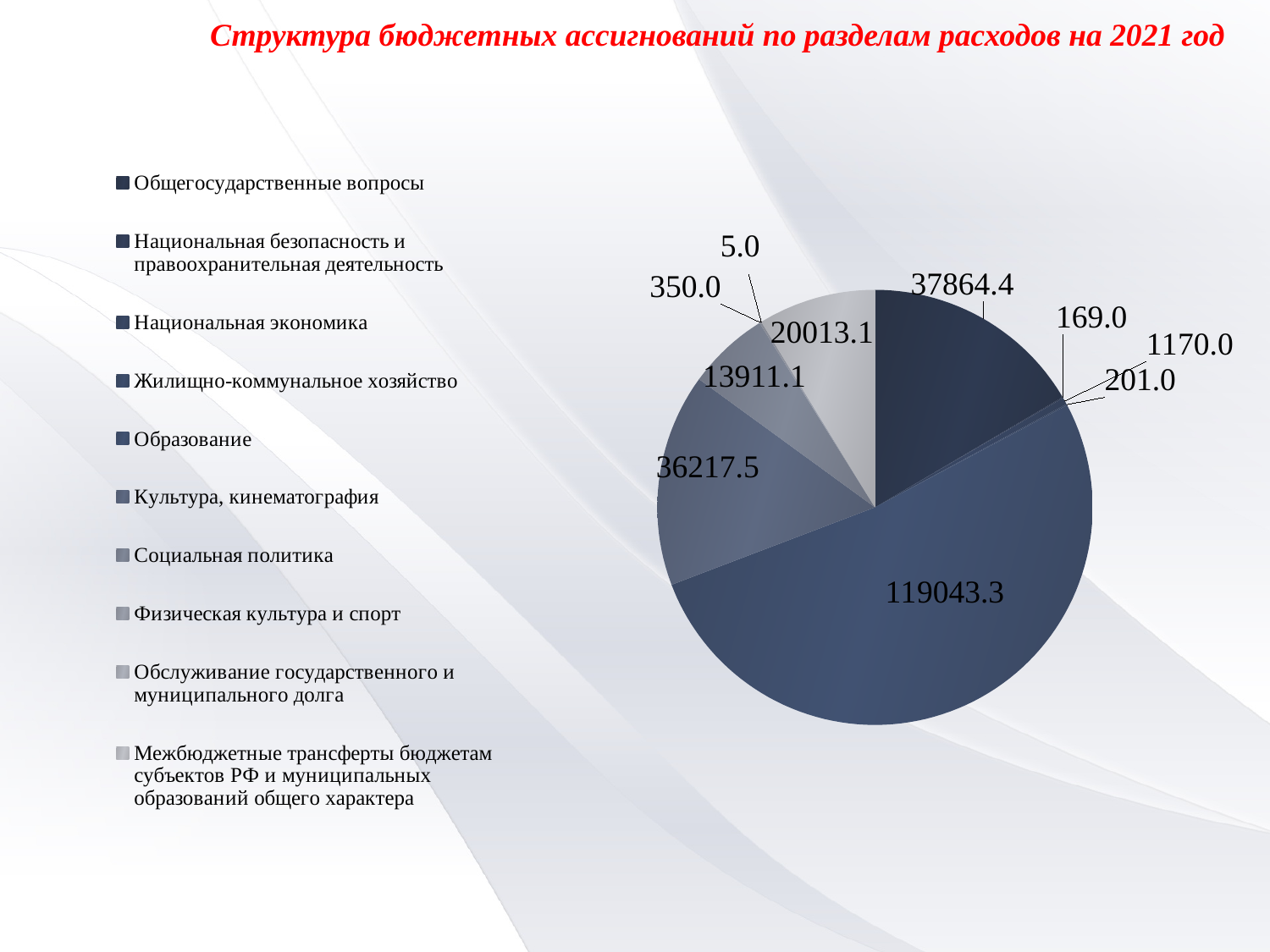
What is the value of the smallest slice in the pie chart? 5.0 What is the value shown for Культура, кинематография? 36217.5 How many categories does the legend of the pie chart list? 10 What is the value of the largest slice in the pie chart? 119043.3 What is the value shown for Физическая культура и спорт? 350.0 What is the title of the slide's chart? Структура бюджетных ассигнований по разделам расходов на 2021 год Which category has the largest slice in the pie chart? Образование What is the value shown for Общегосударственные вопросы? 37864.4 What is the difference between the slice labelled 1170.0 and the slice labelled 350.0? 820.0 Which is larger: the slice labelled 37864.4 or the slice labelled 36217.5? 37864.4 What type of chart is shown on the slide? pie chart What is the difference between the slice labelled 20013.1 and the slice labelled 13911.1? 6102.0